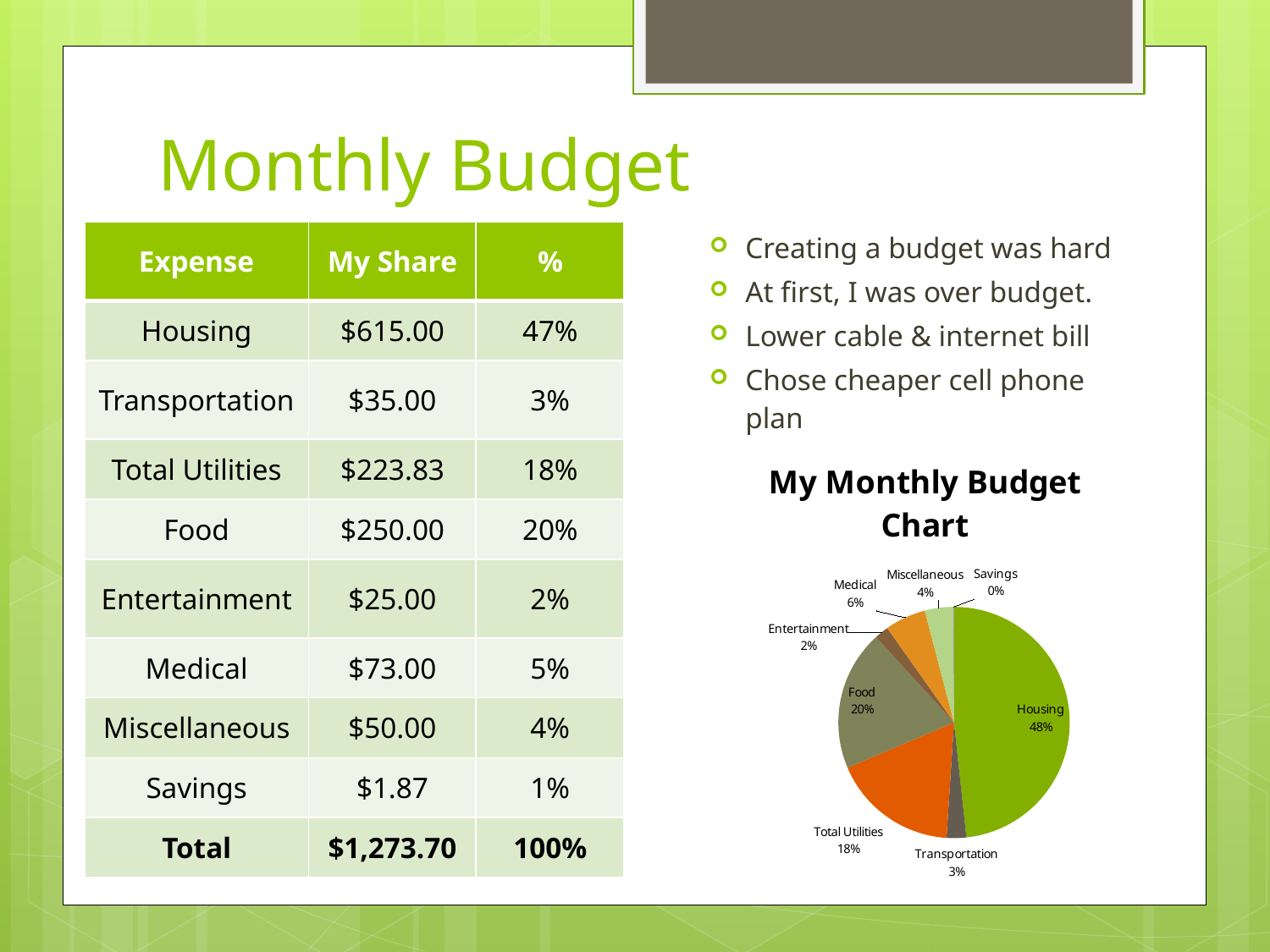
Which category has the smallest slice in the pie chart? Savings Which category has the largest slice in the pie chart? Housing In the pie chart, which slice is larger, Medical or Miscellaneous? Medical How many slices (categories) does the pie chart have? 8 In the pie chart, what percentage is shown for Medical? 6% In the pie chart, what percentage is shown for Housing? 48% In the pie chart, what percentage is shown for Food? 20% What is the title of the pie chart on the slide? My Monthly Budget Chart What kind of chart is "My Monthly Budget Chart"? pie chart In the pie chart, what percentage is shown for Total Utilities? 18% In the pie chart, what is the difference in percentage points between Food and Total Utilities? 2% In the pie chart, what percentage is shown for Savings? 0%